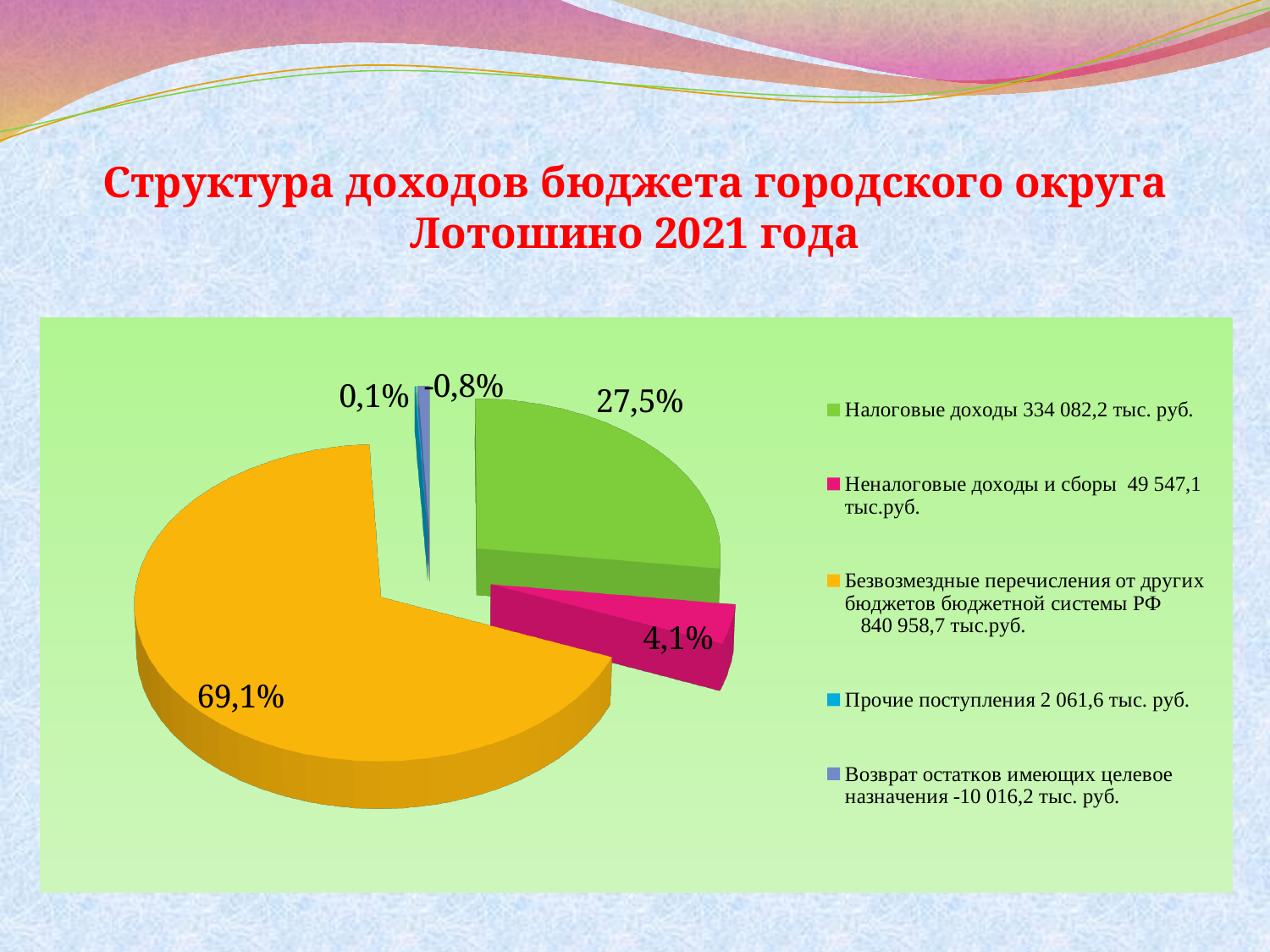
What share of the pie does Безвозмездные перечисления от других бюджетов бюджетной системы РФ represent? 69,1% Which is larger: the share for Налоговые доходы or the share for Неналоговые доходы и сборы? Налоговые доходы What percentage is shown for Неналоговые доходы и сборы? 4,1% What is the difference in percentage points between Безвозмездные перечисления (69,1%) and Налоговые доходы (27,5%)? 41,6 How many categories does the legend list? 5 What percentage is shown for Возврат остатков имеющих целевое назначения? -0,8% What percentage is shown for Прочие поступления? 0,1% What kind of chart is shown on the slide? Pie chart Which category has the largest share of the pie? Безвозмездные перечисления от других бюджетов бюджетной системы РФ What share of the pie does Налоговые доходы represent? 27,5% What amount in тыс. руб. does the legend give for Налоговые доходы? 334 082,2 тыс. руб.